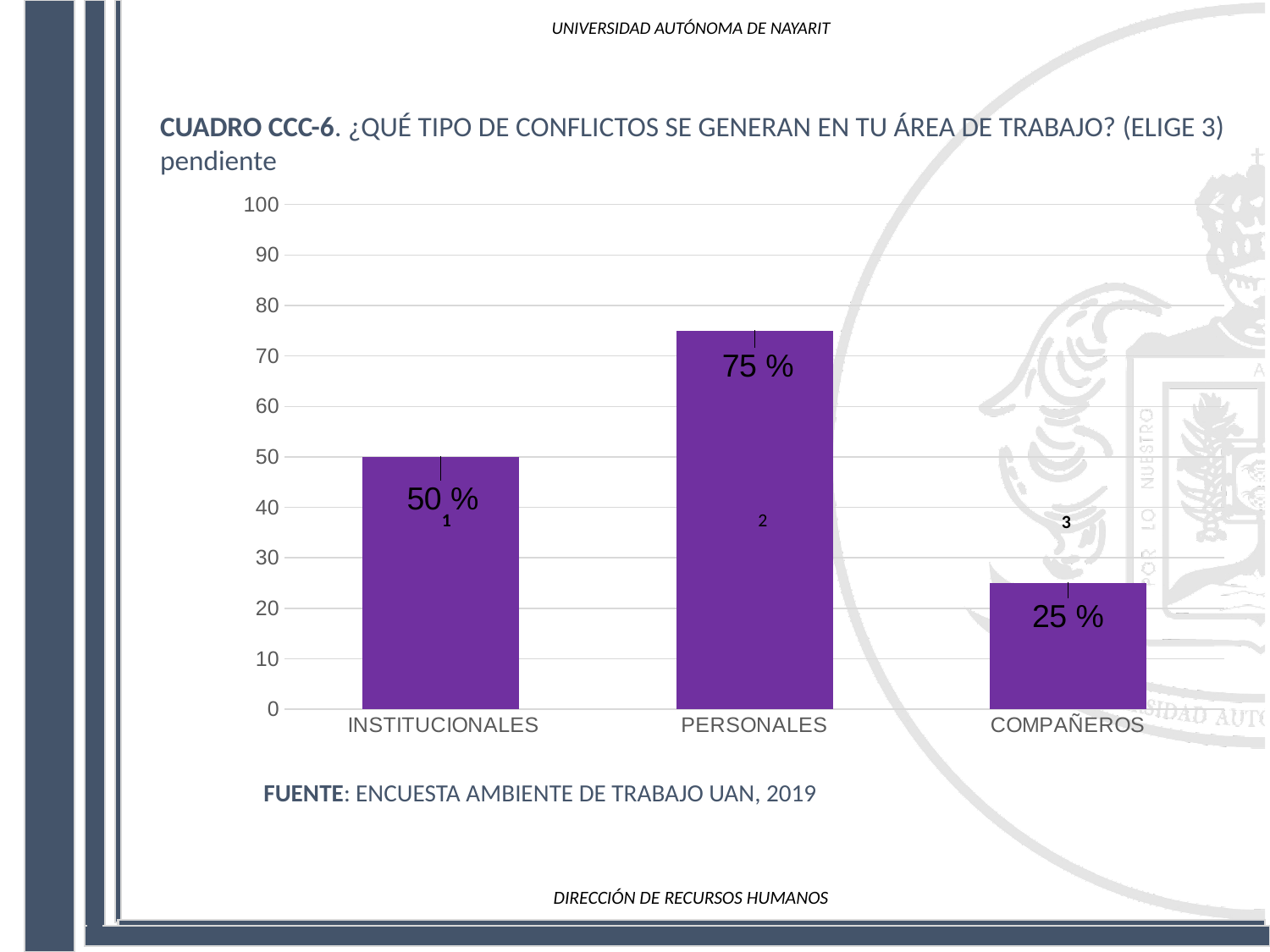
What is the value for PERSONALES? 75 % What is the value for COMPAÑEROS? 25 % Is the value for PERSONALES greater or less than 70? greater What is the difference between the values for INSTITUCIONALES and COMPAÑEROS? 25 % Which is larger, the value for INSTITUCIONALES or the value for COMPAÑEROS? INSTITUCIONALES How many categories are shown on the chart? 3 What is the value for INSTITUCIONALES? 50 % What source is cited below the chart? ENCUESTA AMBIENTE DE TRABAJO UAN, 2019 What is the difference between the values for PERSONALES and INSTITUCIONALES? 25 % Which category has the highest value? PERSONALES What kind of chart is shown on the slide? Bar chart Which category has the lowest value? COMPAÑEROS